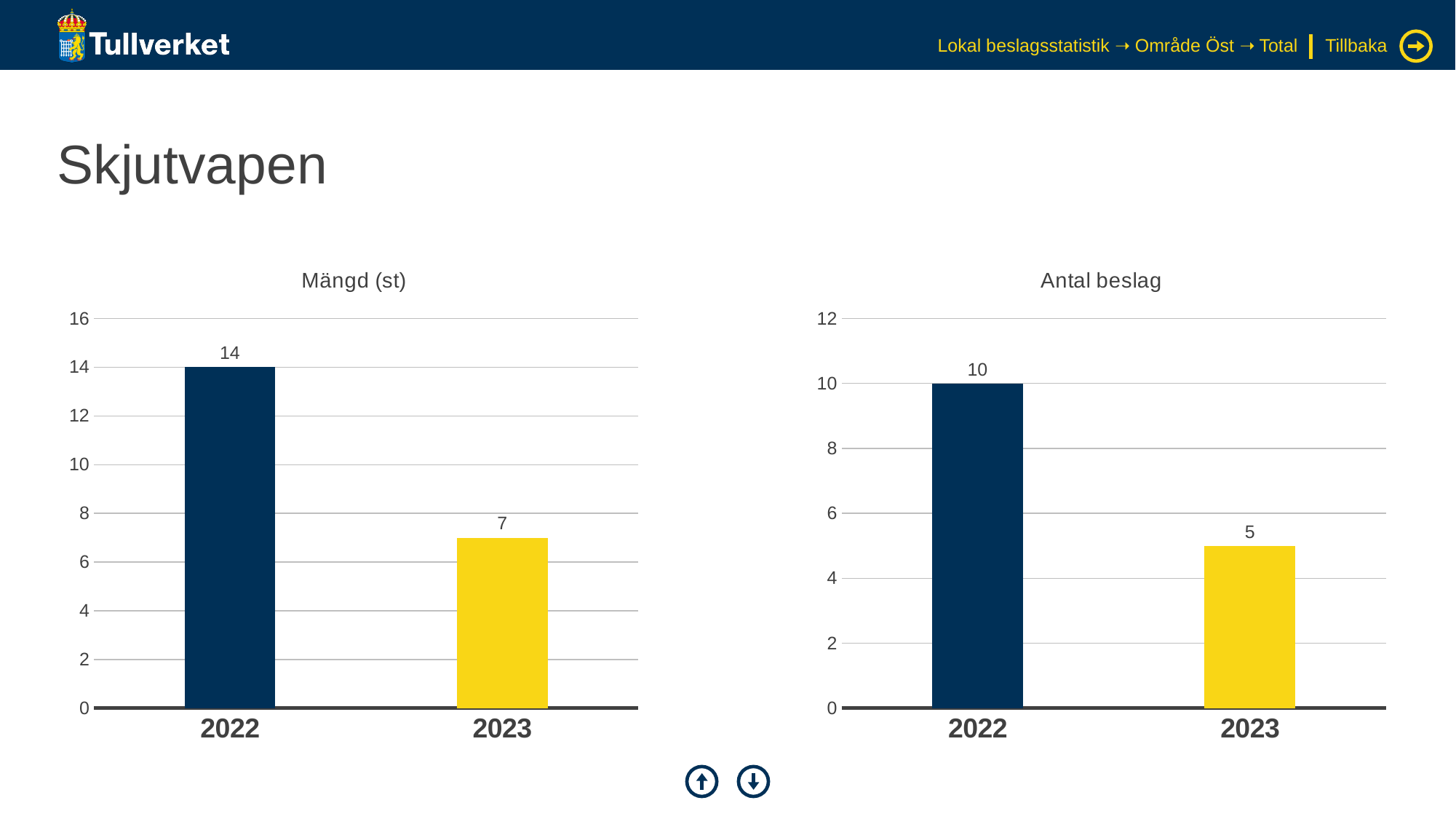
In the "Mängd (st)" chart, which year has the highest value? 2022 In the "Mängd (st)" chart, do the values rise or fall from 2022 to 2023? fall In the "Mängd (st)" chart, what is the difference between the values for 2022 and 2023? 7 In the "Mängd (st)" chart, what is the value for 2022? 14 In the "Antal beslag" chart, is the value for 2022 larger or smaller than the value for 2023? larger In the "Antal beslag" chart, what is the value for 2023? 5 In the "Mängd (st)" chart, what is the value for 2023? 7 In the "Mängd (st)" chart, how many years are shown on the x axis? 2 In the "Antal beslag" chart, which year has the lowest value? 2023 In the "Antal beslag" chart, what is the difference between the values for 2022 and 2023? 5 What kind of chart is the "Antal beslag" chart? bar chart In the "Antal beslag" chart, what is the value for 2022? 10